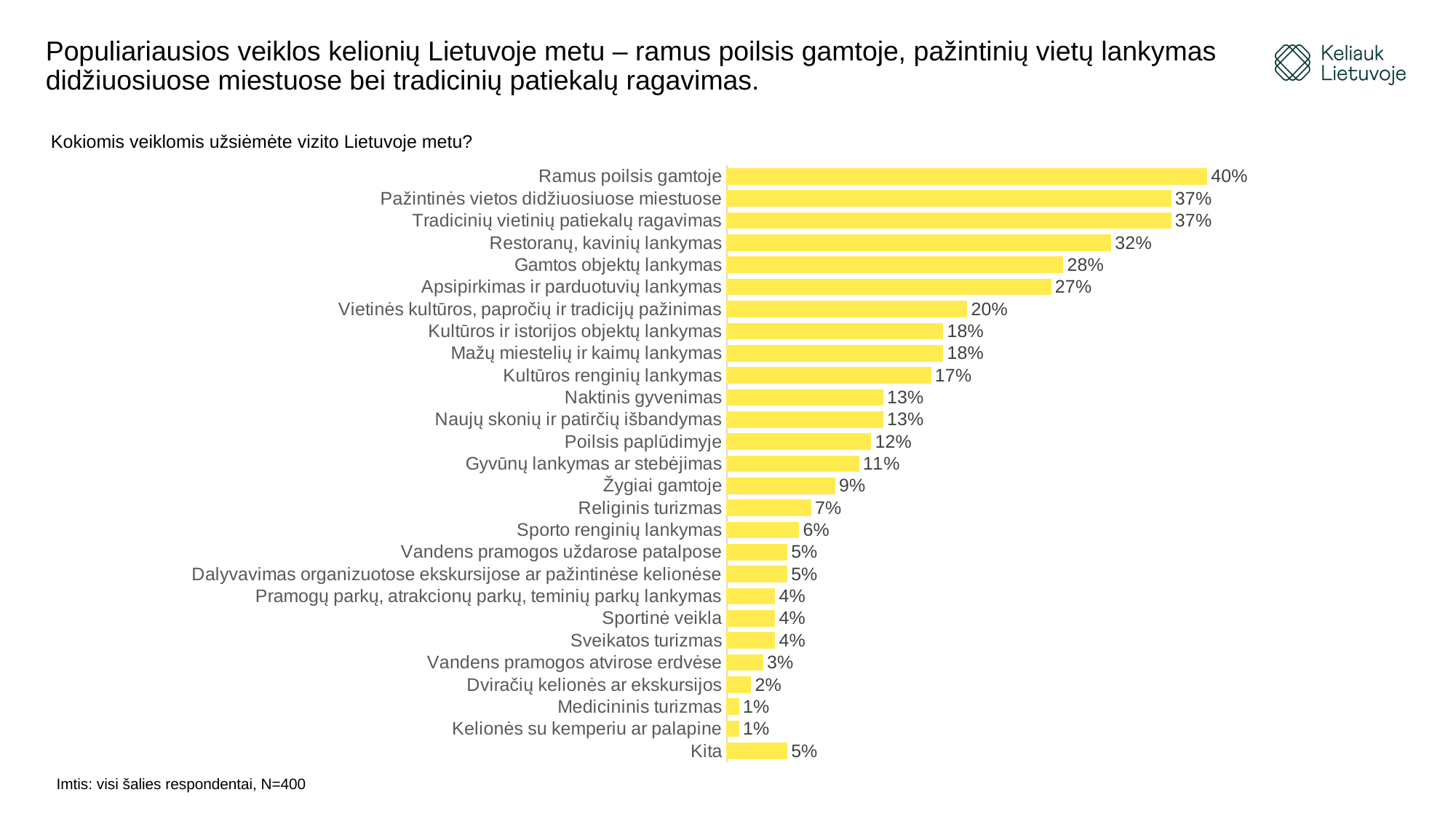
What is the value for Kita? 5% What is the difference between Ramus poilsis gamtoje and Gamtos objektų lankymas? 12% What is the value for Restoranų, kavinių lankymas? 32% What is the value for Naktinis gyvenimas? 13% What is the lowest value shown in the chart? 1% What is the difference between Apsipirkimas ir parduotuvių lankymas and Žygiai gamtoje? 18% Which activity has the highest value? Ramus poilsis gamtoje What question is shown above the chart? Kokiomis veiklomis užsiėmėte vizito Lietuvoje metu? Which is larger, Poilsis paplūdimyje or Religinis turizmas? Poilsis paplūdimyje What kind of chart is shown on the slide? bar chart How many categories are shown in the chart? 27 What is the value for Ramus poilsis gamtoje? 40%